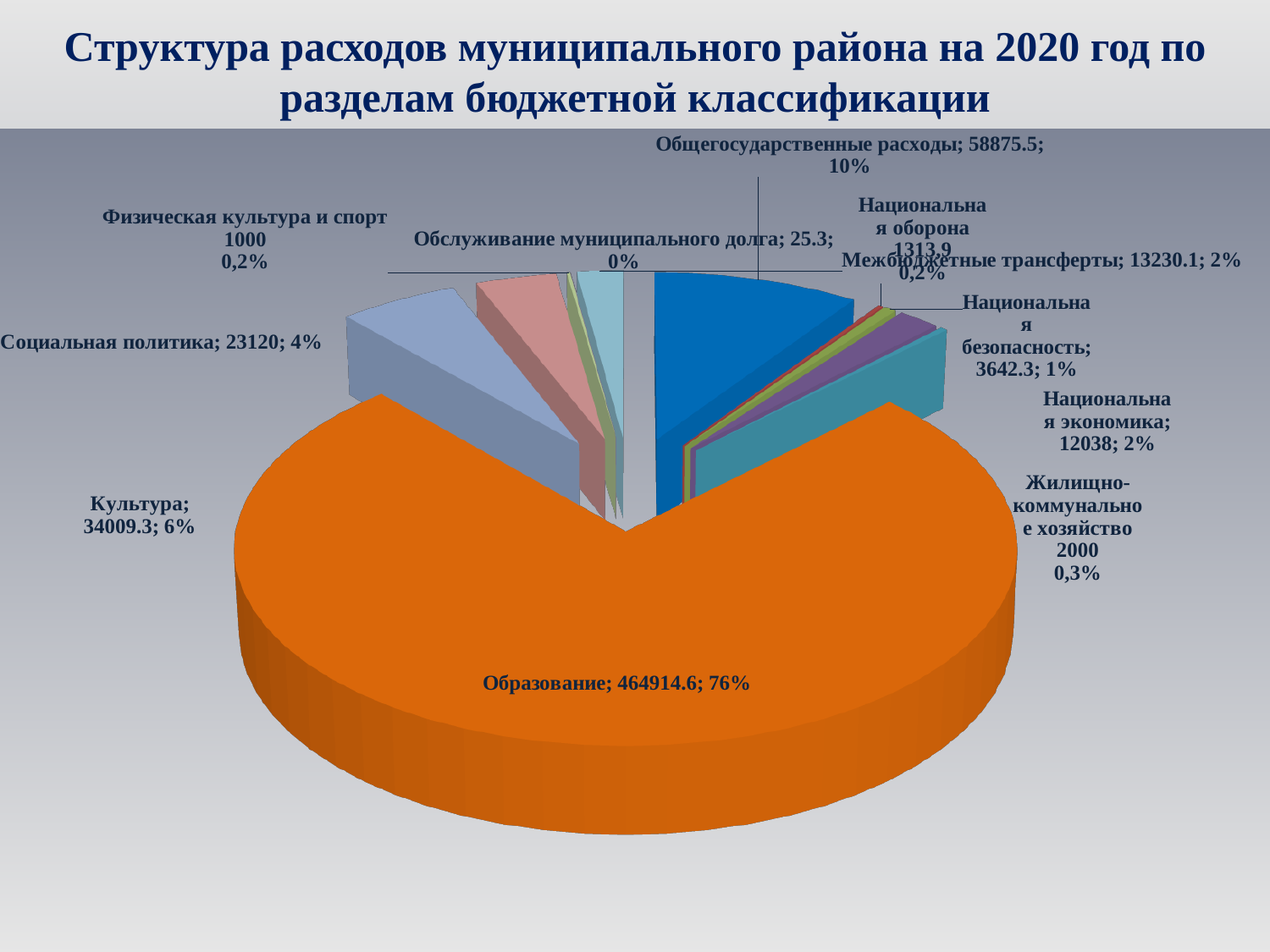
Which is larger: Межбюджетные трансферты or Национальная экономика? Межбюджетные трансферты What is the difference between the values for Социальная политика and Национальная экономика? 11082 Which category has the largest slice of the pie? Образование How many categories are shown in the pie chart? 11 Which category has the smallest value in the pie chart? Обслуживание муниципального долга What share of the pie does Культура represent? 6% What is the value shown for Образование? 464914.6 What is the value shown for Социальная политика? 23120 What is the value shown for Общегосударственные расходы? 58875.5 What share of the pie does Образование represent? 76% What type of chart is shown on the slide? Pie chart What is the title of the slide? Структура расходов муниципального района на 2020 год по разделам бюджетной классификации